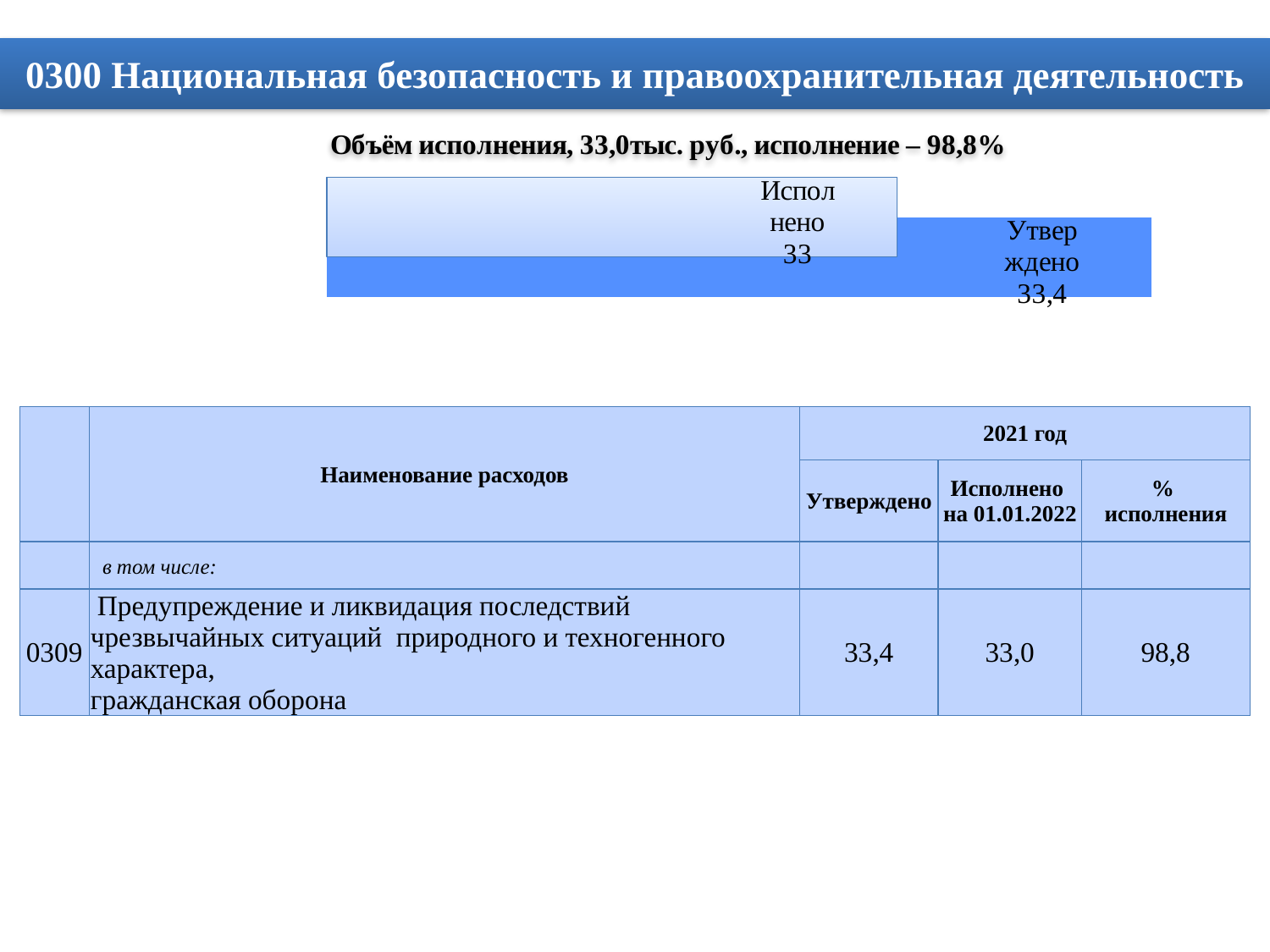
What is the title printed above the chart? Объём исполнения, 33,0тыс. руб., исполнение – 98,8% What is the difference between the "Утверждено" value and the "Исполнено" value? 0,4 Which bar shows the highest value? Утверждено What value is shown for the bar labelled "Утверждено"? 33,4 Which bar has the higher value, "Исполнено" or "Утверждено"? Утверждено What kind of chart is shown on the slide? bar chart Are the bars in the chart oriented horizontally or vertically? horizontally Which bar shows the lowest value? Исполнено How many bars does the chart contain? 2 What value is shown for the bar labelled "Исполнено"? 33